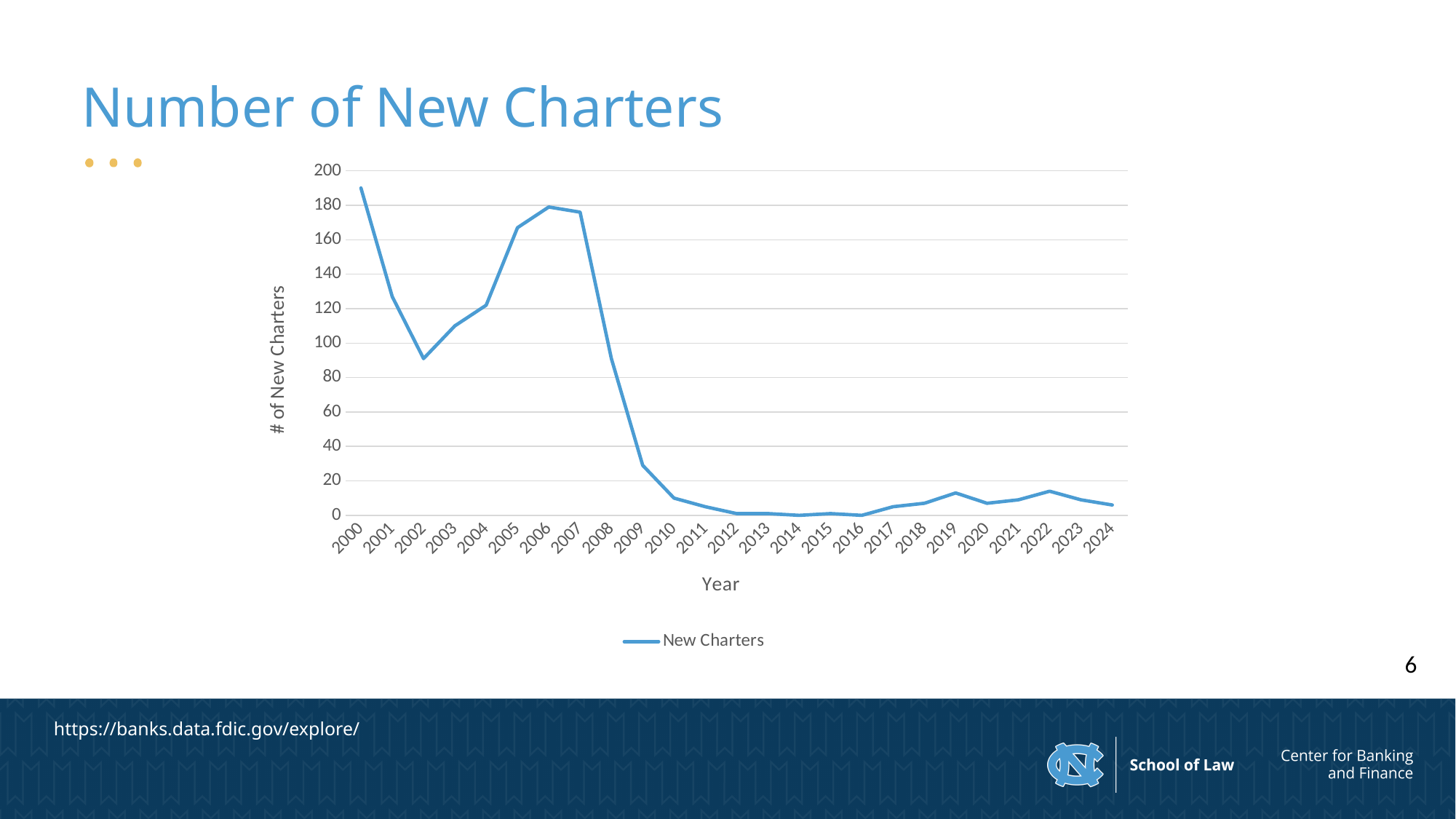
Is the value for 2010 greater or less than 20? less How many years are plotted along the x axis? 25 Is the value for 2002 greater or less than 100? less Which year has the larger number of new charters, 2019 or 2020? 2019 Is the value for 2005 greater or less than 160? greater Which year has the highest number of new charters? 2000 How many series does the legend list? 1 Which year has the larger number of new charters, 2006 or 2009? 2006 Do the values rise or fall from 2006 to 2010? fall What kind of chart is shown on the slide? line chart What is the label on the y axis? # of New Charters